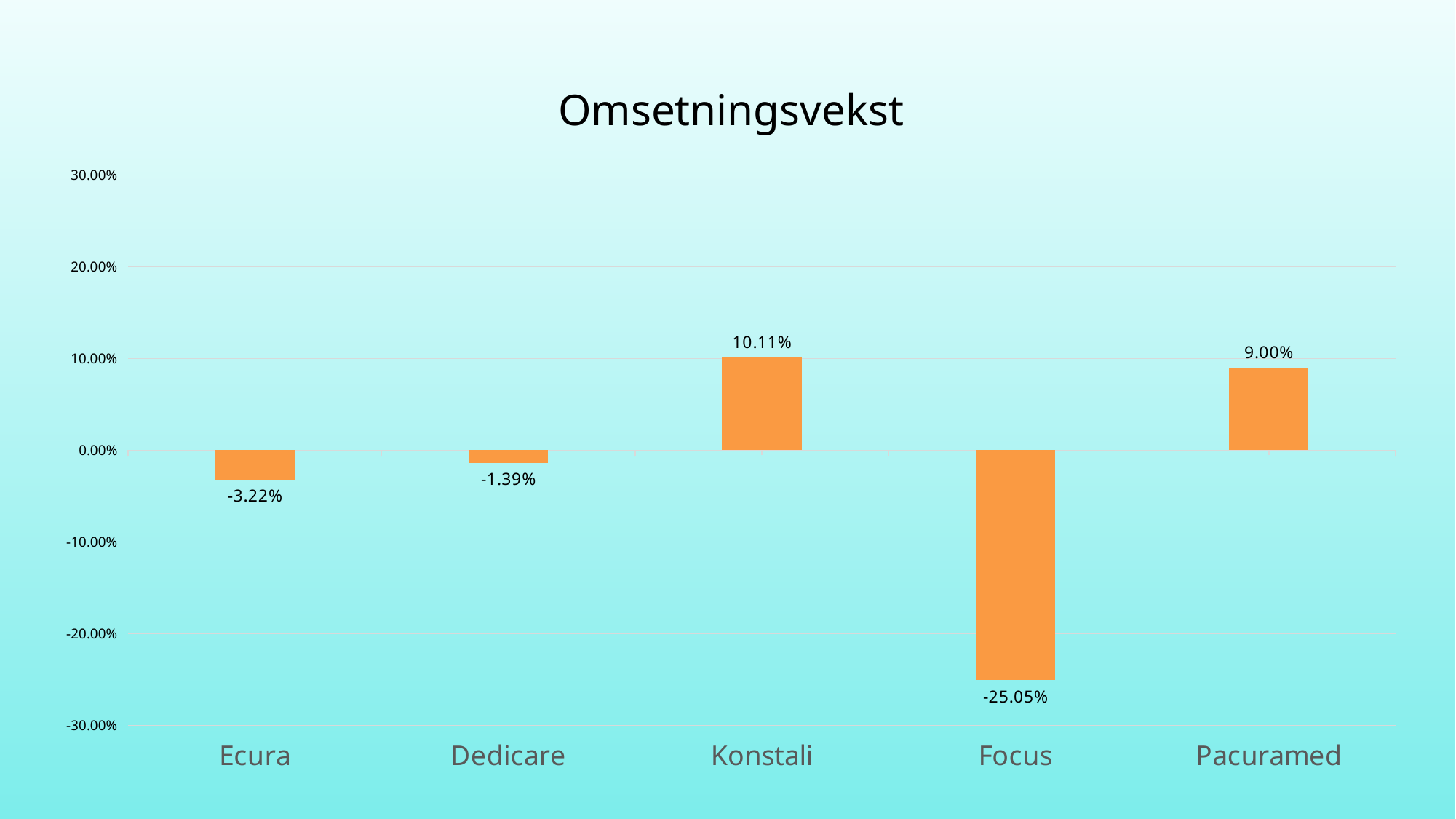
What is the value for Ecura? -3.22% What is the title of the chart? Omsetningsvekst What is the value for Focus? -25.05% What is the value for Konstali? 10.11% Which is larger, the value for Ecura or the value for Dedicare? Dedicare What is the value for Dedicare? -1.39% Which category has the highest value? Konstali Which category has the lowest value? Focus How many categories are shown on the x axis? 5 What kind of chart is this? Bar chart What is the difference between the values for Konstali and Pacuramed? 1.11% What is the value for Pacuramed? 9.00%